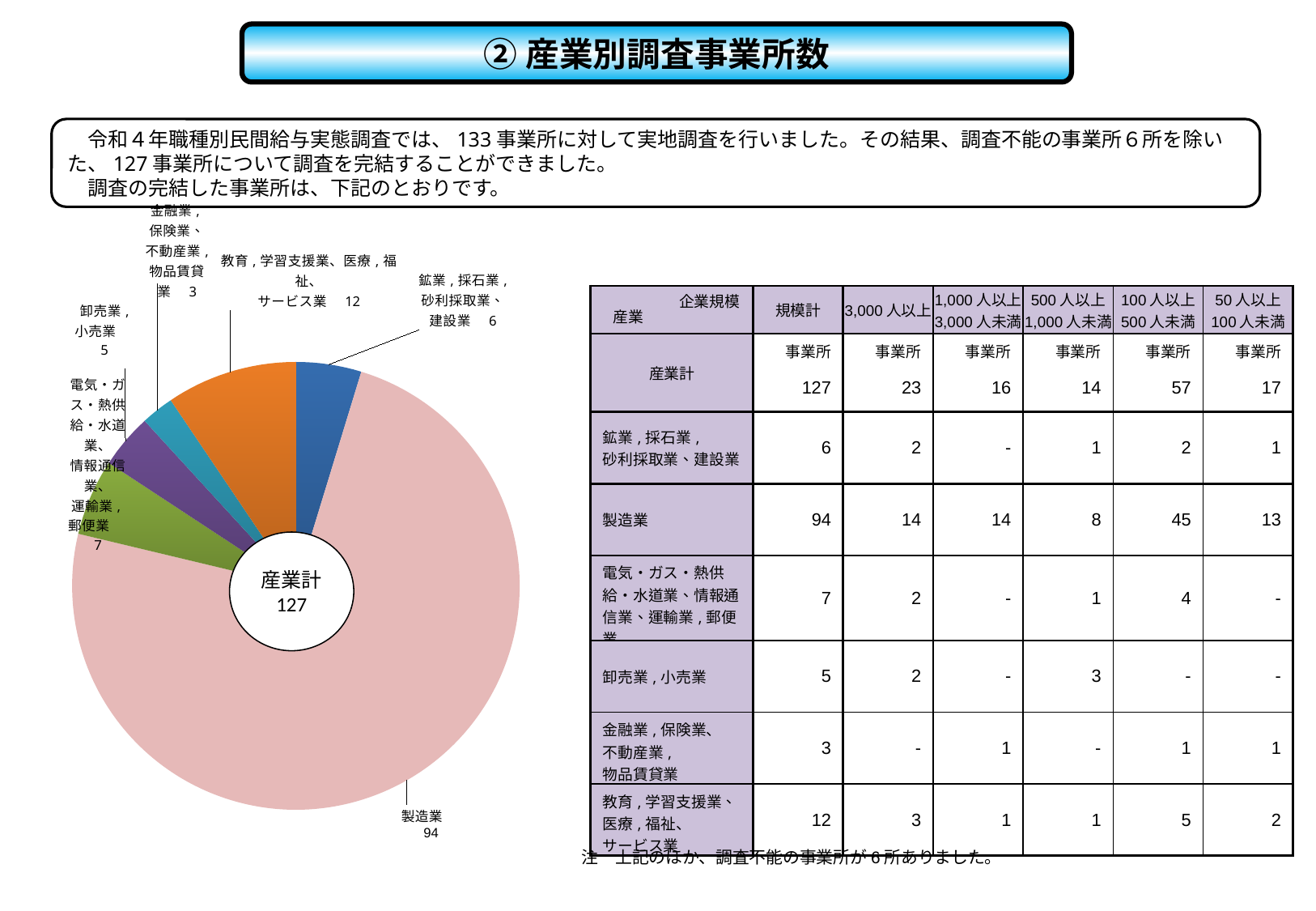
In the pie chart, what is the value for 鉱業,採石業,砂利採取業、建設業? 6 In the pie chart, which is larger: the value for 電気・ガス・熱供給・水道業、情報通信業、運輸業,郵便業 or the value for 卸売業,小売業? 電気・ガス・熱供給・水道業、情報通信業、運輸業,郵便業 In the pie chart, what is the value for 金融業,保険業、不動産業,物品賃貸業? 3 What type of chart is shown on the left of the slide? pie chart In the pie chart, what is the value for 製造業? 94 Which category has the largest slice in the pie chart? 製造業 In the pie chart, what is the value for 教育,学習支援業、医療,福祉、サービス業? 12 What total is printed in the centre of the pie chart? 127 In the pie chart, what is the value for 卸売業,小売業? 5 In the pie chart, what is the difference between the value for 製造業 and the value for 教育,学習支援業、医療,福祉、サービス業? 82 Which category has the smallest slice in the pie chart? 金融業,保険業、不動産業,物品賃貸業 How many categories (slices) does the pie chart show? 6